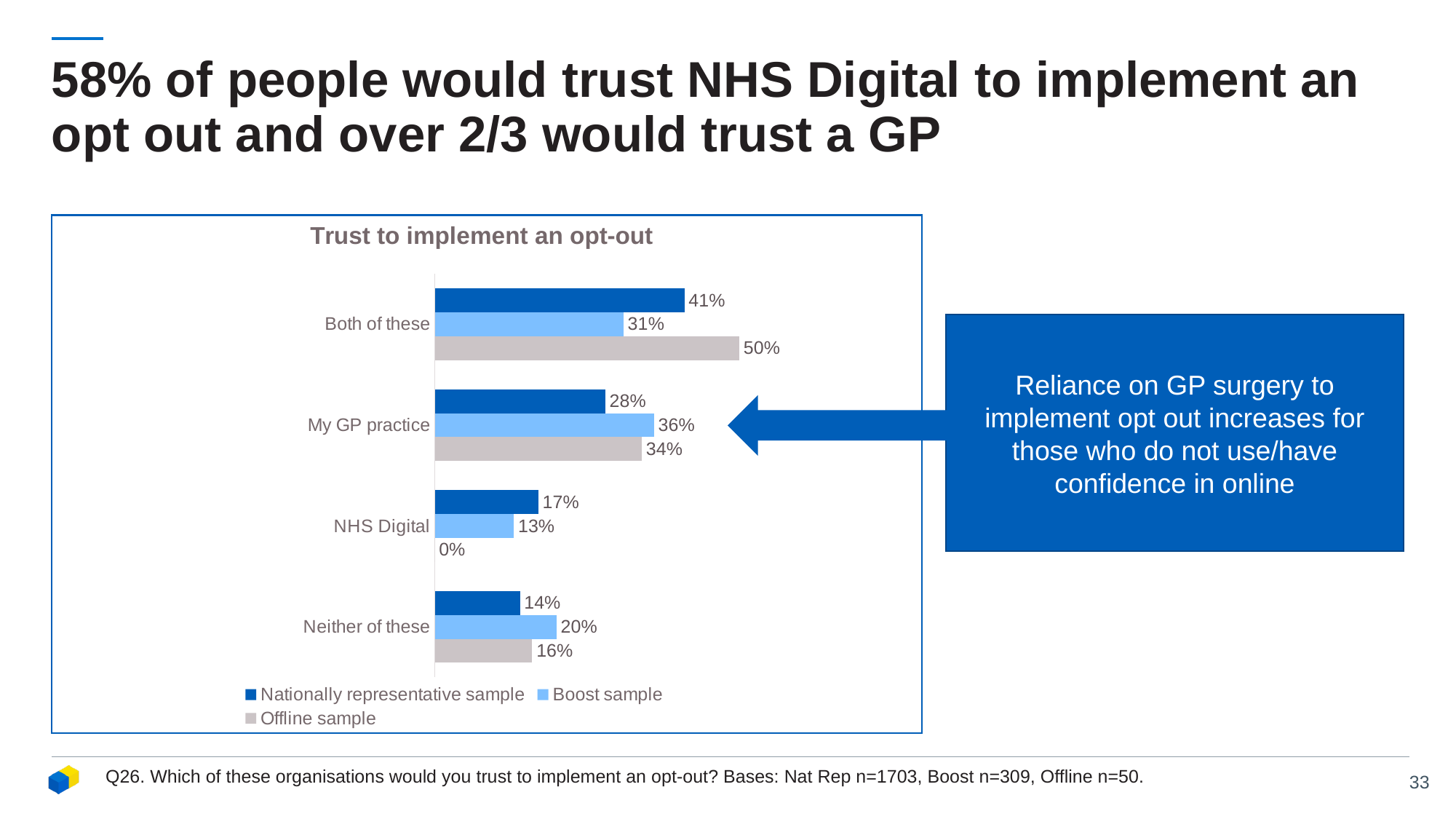
What kind of chart is shown? Bar chart Which category has the highest Offline sample value? Both of these What is the title of the chart? Trust to implement an opt-out What is the Boost sample value for 'My GP practice'? 36% What is the difference between the Offline sample and Boost sample values for 'Both of these'? 19 percentage points Which series is shown in grey? Offline sample How many categories are shown on the chart? 4 Which category has the lowest Boost sample value? NHS Digital For 'Neither of these', which is larger: the Boost sample or the Nationally representative sample value? Boost sample What is the Offline sample value for 'NHS Digital'? 0% What is the Nationally representative sample value for 'Both of these'? 41% How many series does the legend list? 3